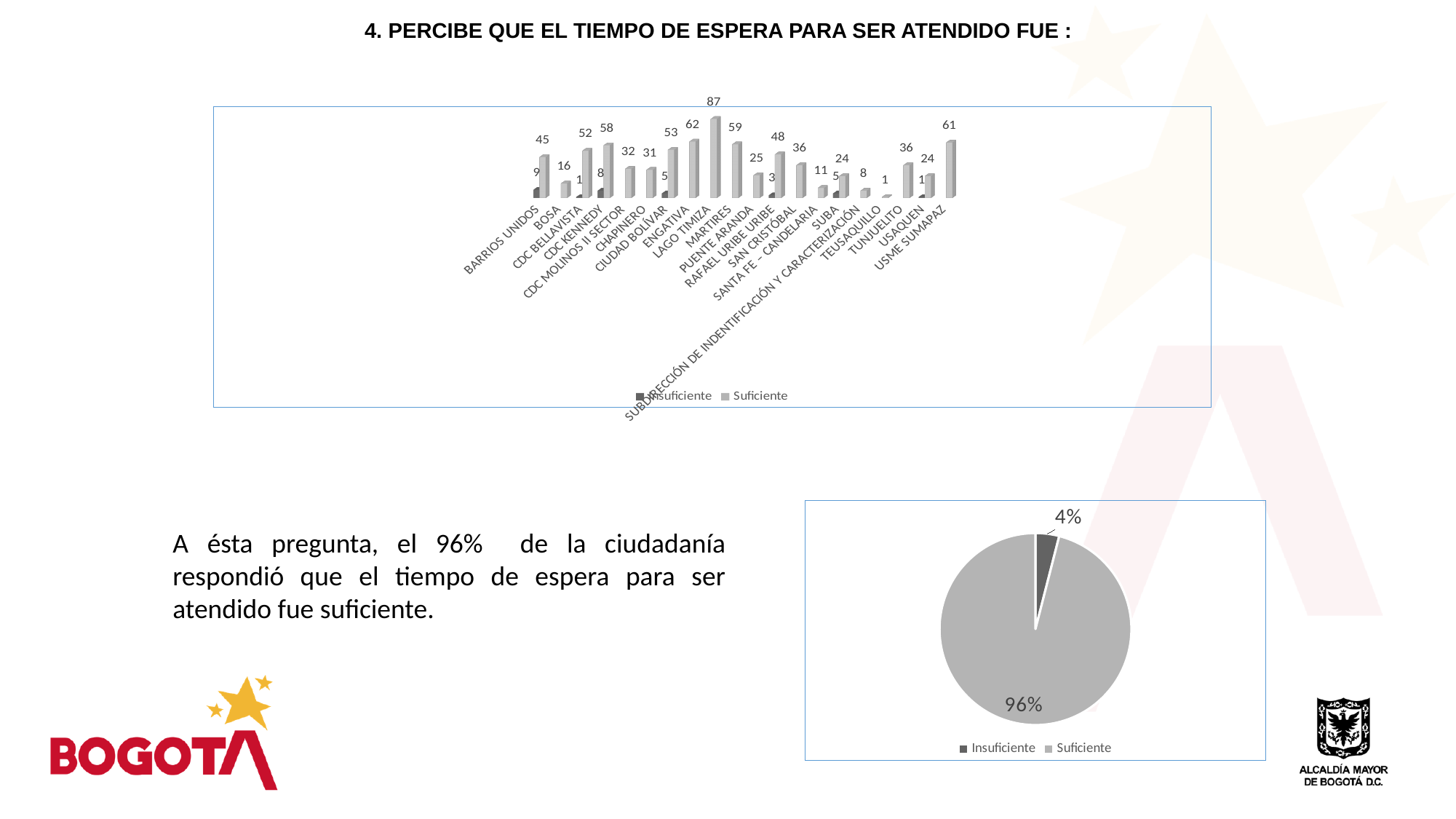
What kind of chart is the top chart on the slide? bar chart In the top bar chart, what is the Suficiente value for USME SUMAPAZ? 61 In the top bar chart, how many series does the legend list? 2 In the top bar chart, what is the Suficiente value for BARRIOS UNIDOS? 45 In the top bar chart, what is the Suficiente value for LAGO TIMIZA? 87 In the top bar chart, which category has the highest Suficiente value? LAGO TIMIZA In the top bar chart, how many categories are shown on the x axis? 20 What kind of chart is the bottom-right chart on the slide? pie chart In the bottom-right pie chart, what share of responses is Suficiente? 96% In the top bar chart, what are the two legend entries? Insuficiente and Suficiente In the top bar chart, which has a larger Suficiente value, LAGO TIMIZA or ENGATIVA? LAGO TIMIZA In the bottom-right pie chart, what share of responses is Insuficiente? 4%